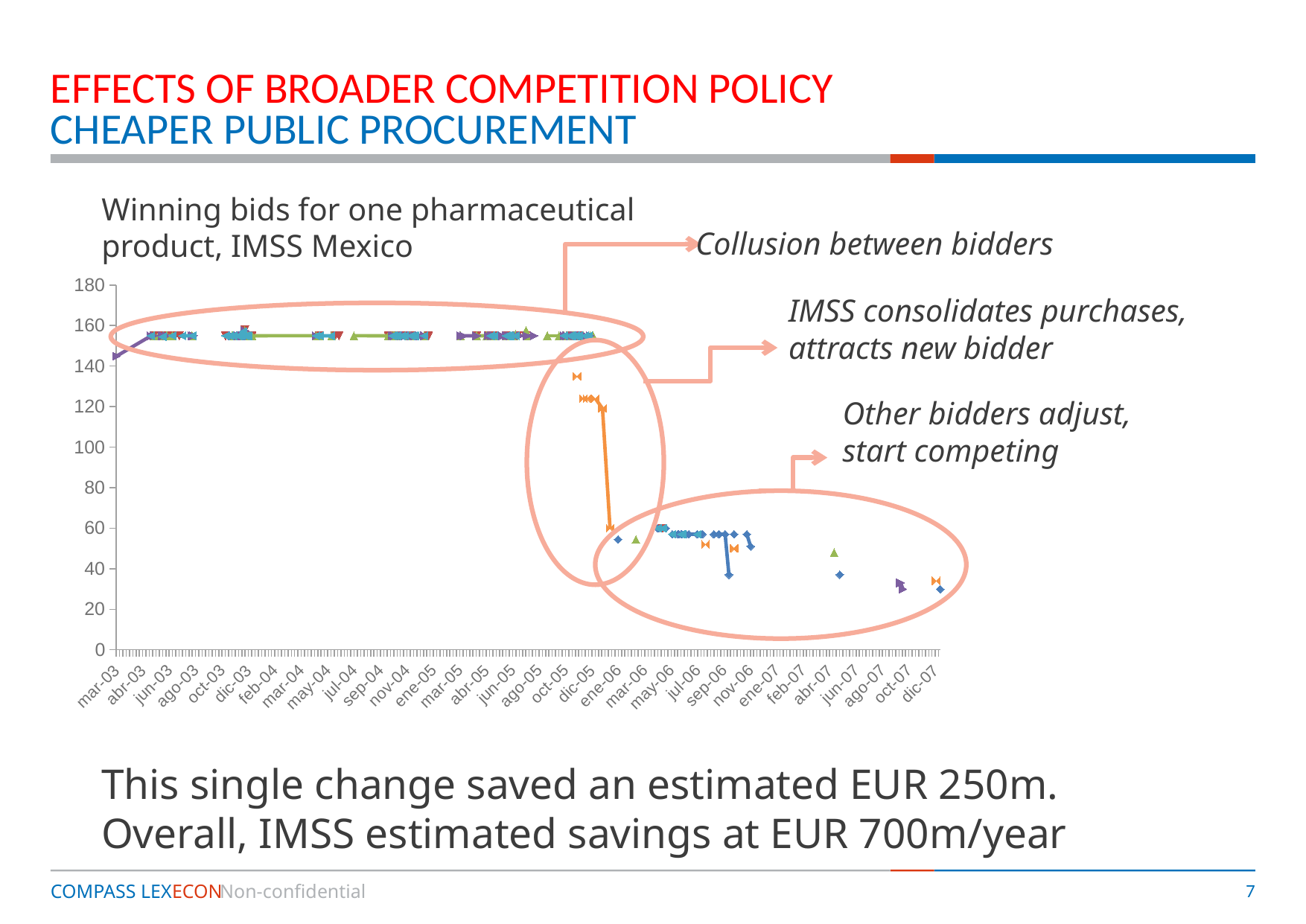
Are the winning bid values in jul-06 greater or less than 80? less What is the first month label on the x axis? mar-03 Are the winning bid values in mar-05 greater or less than 160? less Which period has lower winning bids, dic-07 or dic-05? dic-07 Do the winning bid values rise or fall over time along the x axis? fall What is the last month label on the x axis? dic-07 Which period has higher winning bids, jun-03 or jun-06? jun-03 What kind of chart is shown on the slide? line chart Are the winning bid values in jun-03 greater or less than 140? greater What is the highest value shown on the y axis? 180 What is the title of the chart? Winning bids for one pharmaceutical product, IMSS Mexico